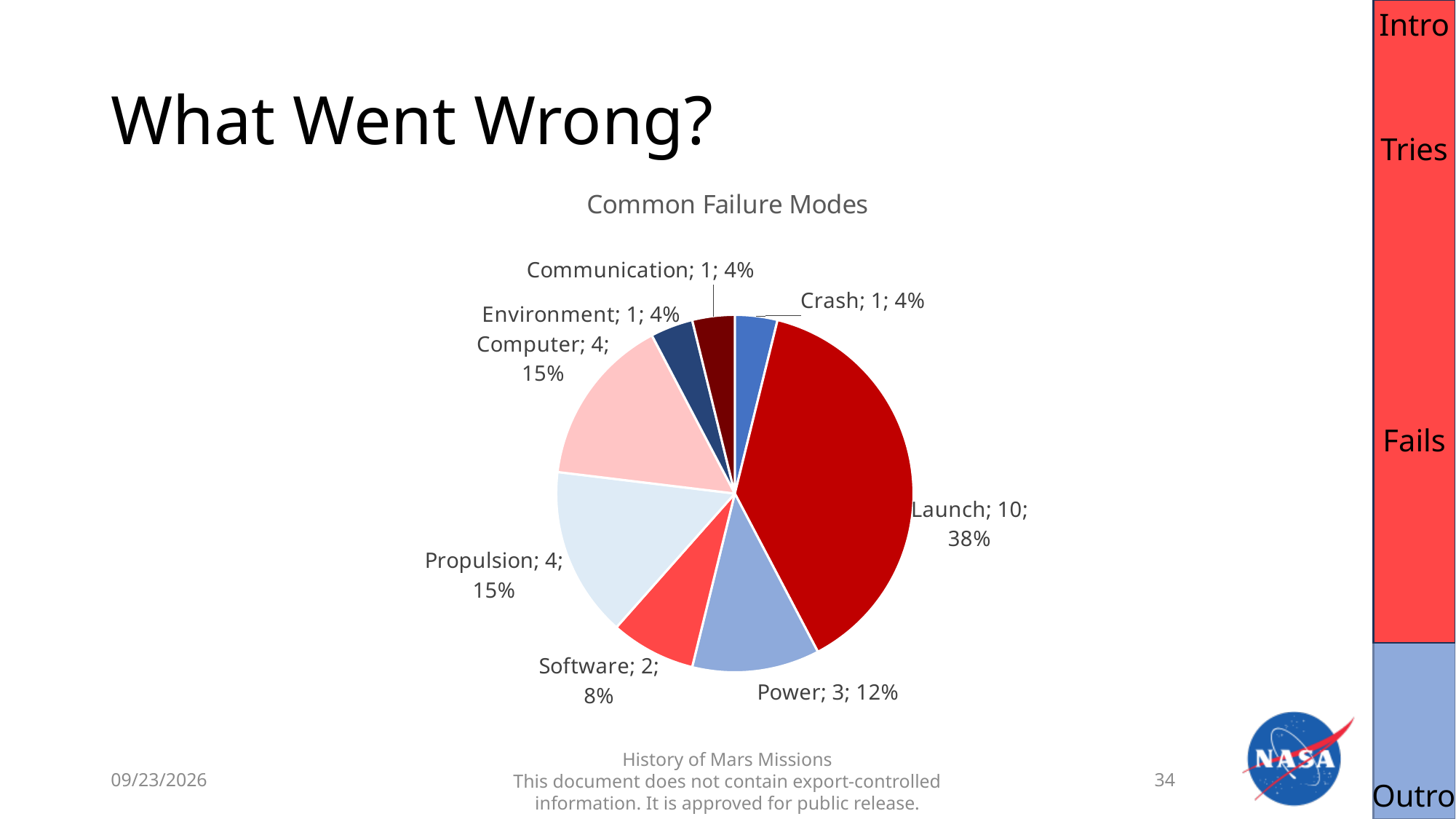
What is the difference between the counts for Launch and Computer? 6 What is the count for Launch? 10 Which failure mode has the largest slice? Launch What percentage share does Software have? 8% What is the count for Software? 2 How many slices does the pie chart have? 8 What percentage share does Environment have? 4% What is the title of the chart? Common Failure Modes What percentage share does Launch have? 38% Which is larger, the count for Propulsion or the count for Power? Propulsion What kind of chart is shown on the slide? pie chart What is the count for Power? 3